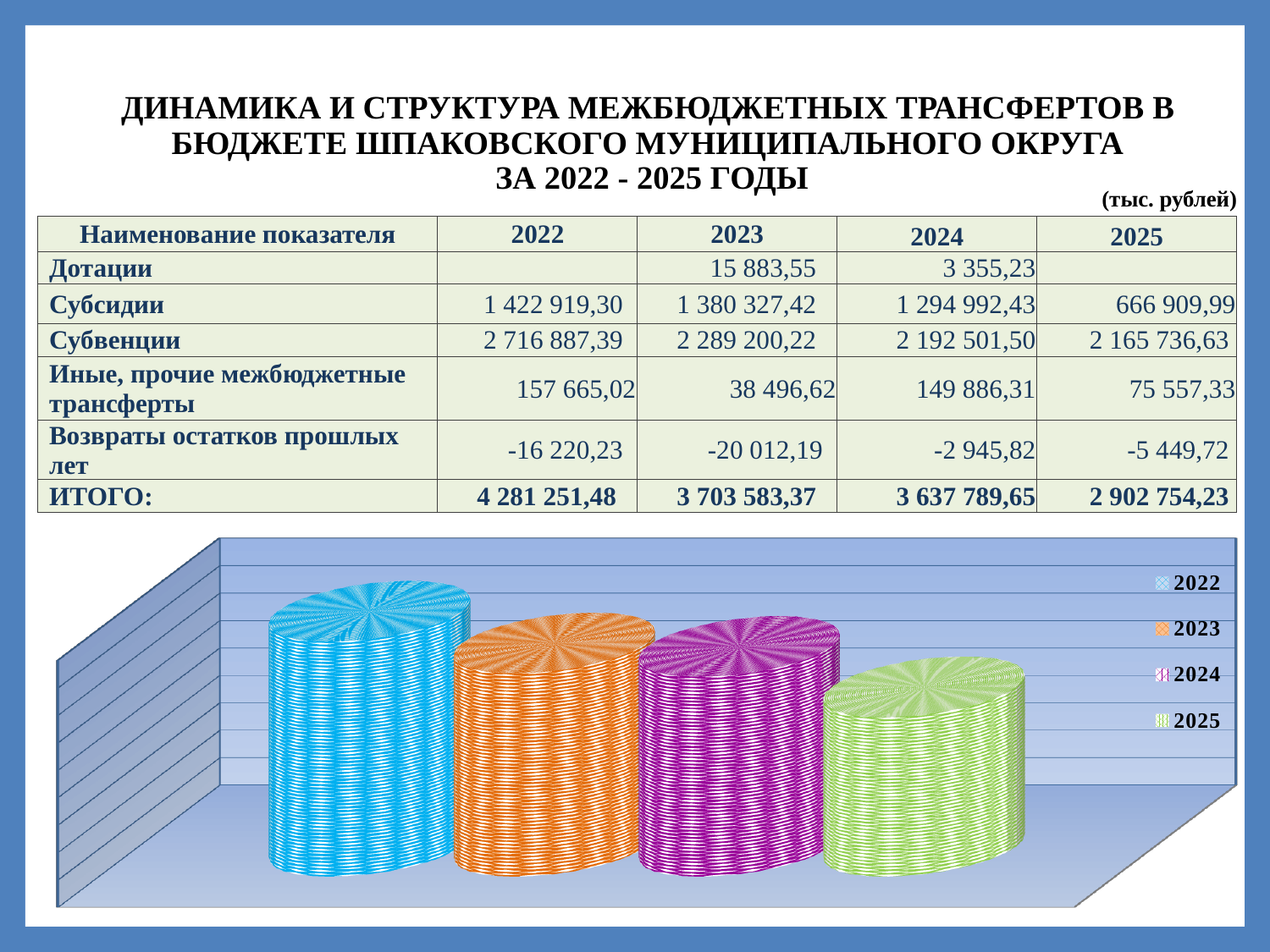
How many bars are plotted in the chart? 4 Do the bar heights rise or fall from 2022 to 2025 in the chart? fall How many series does the chart legend list? 4 Which year has the shortest bar in the chart? 2025 What colour is the bar for 2022 in the chart? blue Which year has the tallest bar in the chart? 2022 What are the entries listed in the chart legend? 2022, 2023, 2024, 2025 In the chart, which bar is taller: 2024 or 2025? 2024 What kind of chart is shown below the table on the slide? bar chart In the chart, which bar is taller: 2022 or 2025? 2022 In the chart, which bar is taller: 2022 or 2023? 2022